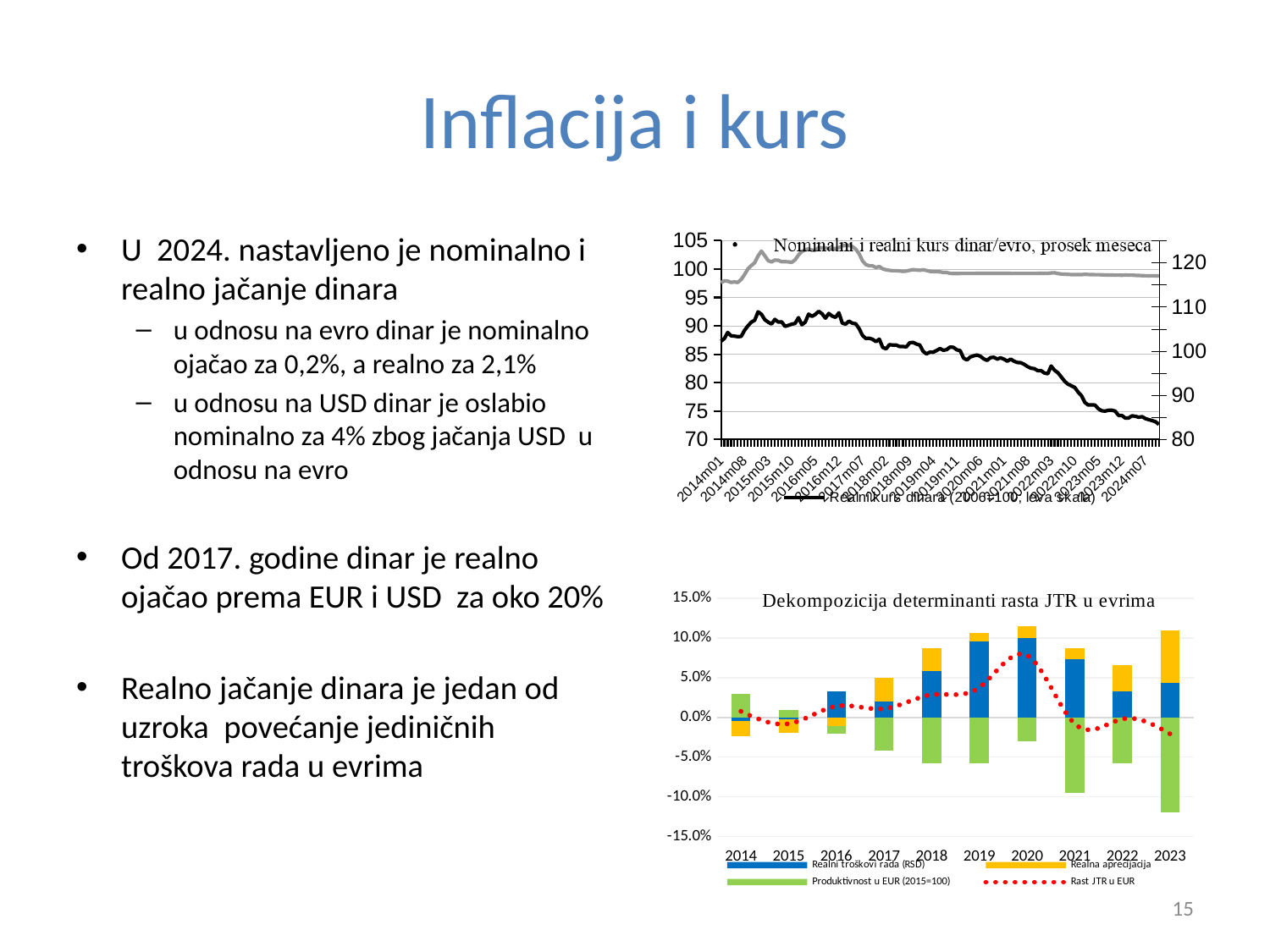
In the bottom chart 'Dekompozicija determinanti rasta JTR u evrima', which series is shown in blue? Realni troškovi rada (RSD) What kind of chart is the bottom chart titled 'Dekompozicija determinanti rasta JTR u evrima'? combination bar and line chart (stacked bars with a dotted line) In the bottom chart 'Dekompozicija determinanti rasta JTR u evrima', in which year does the dotted 'Rast JTR u EUR' line reach its highest point? 2020 How many years are shown on the x axis of the bottom chart 'Dekompozicija determinanti rasta JTR u evrima'? 10 How many series does the legend of the bottom chart 'Dekompozicija determinanti rasta JTR u evrima' list? 4 In the top chart 'Nominalni i realni kurs dinar/evro, prosek meseca', is the value of the black line at the start of the series (2014m01) greater or less than 85 on the left scale? greater In the top chart 'Nominalni i realni kurs dinar/evro, prosek meseca', is the value of the black line at the end of the series (2024) greater or less than 75 on the left scale? less In the bottom chart 'Dekompozicija determinanti rasta JTR u evrima', which year has the lowest (most negative) green 'Produktivnost u EUR' bar? 2023 In the bottom chart 'Dekompozicija determinanti rasta JTR u evrima', which year has the largest yellow 'Realna aprecijacija' segment? 2023 In the top chart 'Nominalni i realni kurs dinar/evro, prosek meseca', does the black line (real exchange rate) rise or fall overall from 2014 to 2024? fall In the bottom chart 'Dekompozicija determinanti rasta JTR u evrima', is the green 'Produktivnost u EUR' bar for 2023 greater or less than -10.0%? less What kind of chart is the top chart titled 'Nominalni i realni kurs dinar/evro, prosek meseca'? line chart